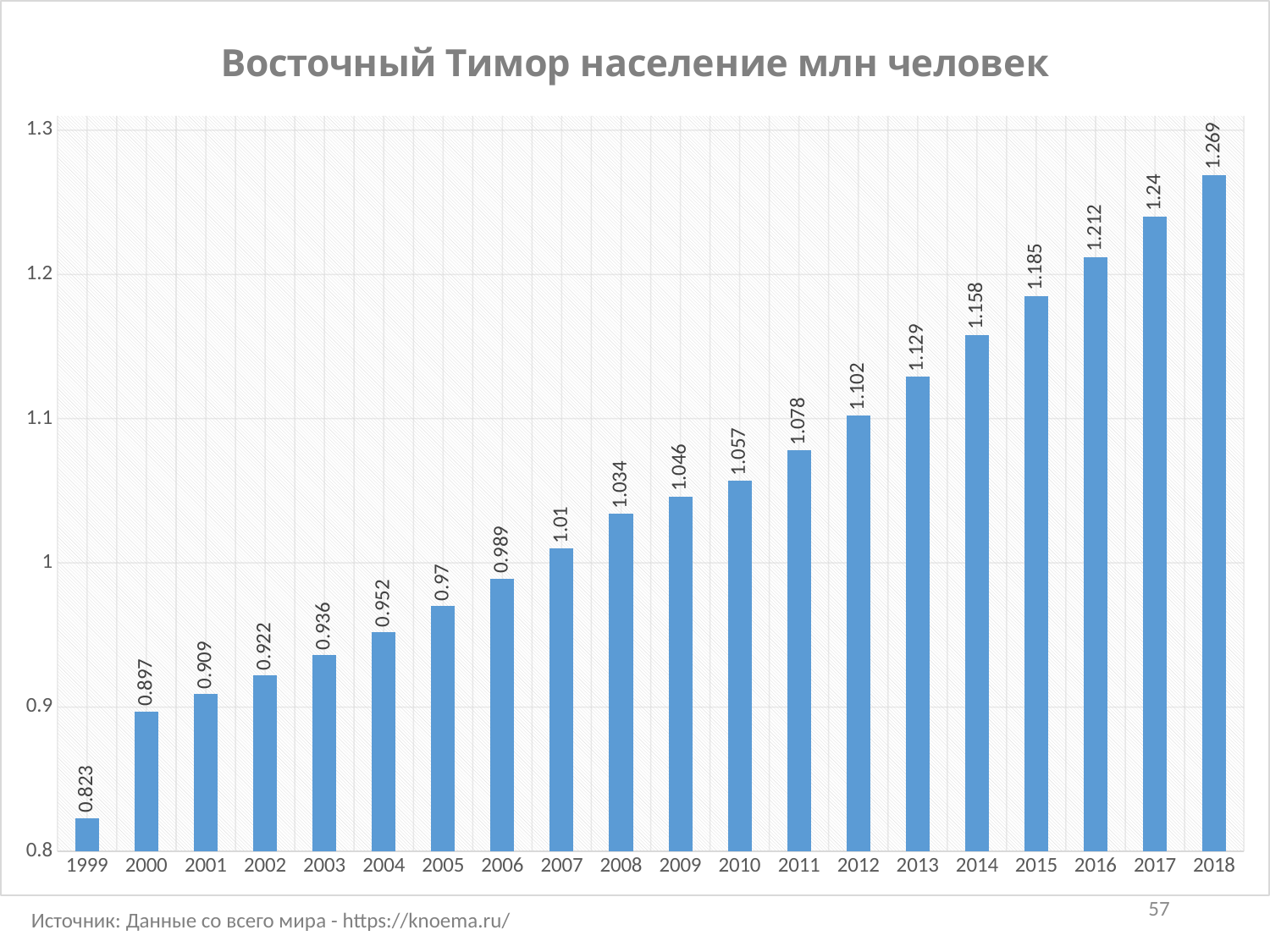
What kind of chart is shown on the slide? bar chart Is the value for 2012 greater or less than 1.1? greater What is the title of the chart? Восточный Тимор население млн человек What is the population value shown for 1999? 0.823 Do the values rise or fall from 1999 to 2018? rise What is the difference between the values for 2018 and 2017? 0.029 Which is larger, the value for 2005 or the value for 2008? 2008 What is the population value shown for 2015? 1.185 What is the population value shown for 2010? 1.057 Which year has the highest population value? 2018 How many years are shown on the x axis? 20 Which year has the lowest population value? 1999